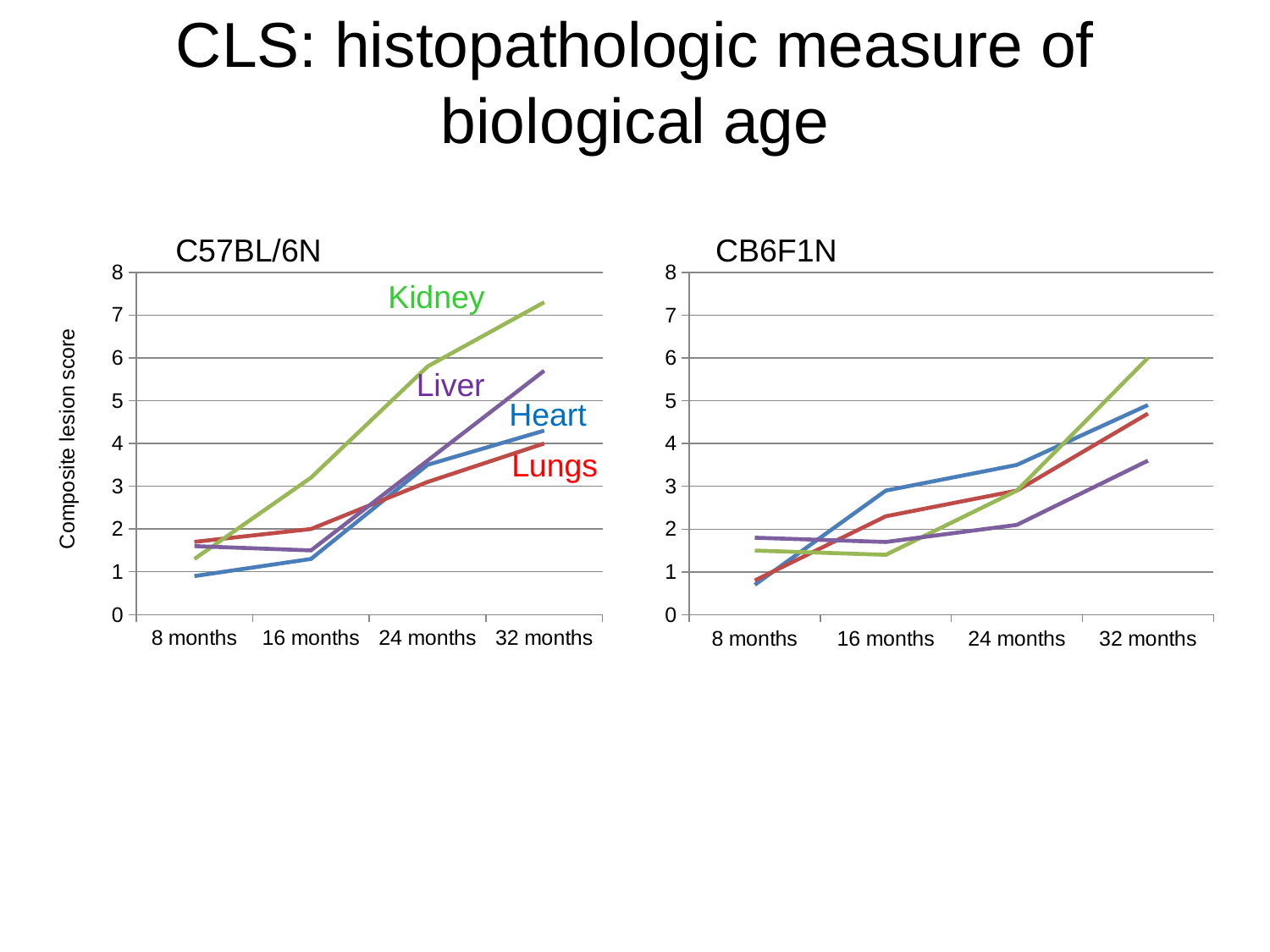
How many time points are shown on the x axis of the CB6F1N chart? 4 What kind of chart is the C57BL/6N chart? line chart In the CB6F1N chart, which organ has the lowest composite lesion score at 32 months? Liver In the C57BL/6N chart, at 24 months, which is larger: the Kidney value or the Lungs value? Kidney In the CB6F1N chart, which organ has the highest composite lesion score at 32 months? Kidney In the C57BL/6N chart, which organ has the highest composite lesion score at 32 months? Kidney In the C57BL/6N chart, does the Kidney line rise or fall from 8 months to 32 months? rises How many organ series are labelled on the C57BL/6N chart? 4 In the CB6F1N chart, is the Liver value at 32 months greater or less than 4? less In the C57BL/6N chart, is the Kidney value at 32 months greater or less than 7? greater In the CB6F1N chart, is the Heart value at 32 months greater or less than 4? greater What is the label on the y axis of the C57BL/6N chart? Composite lesion score